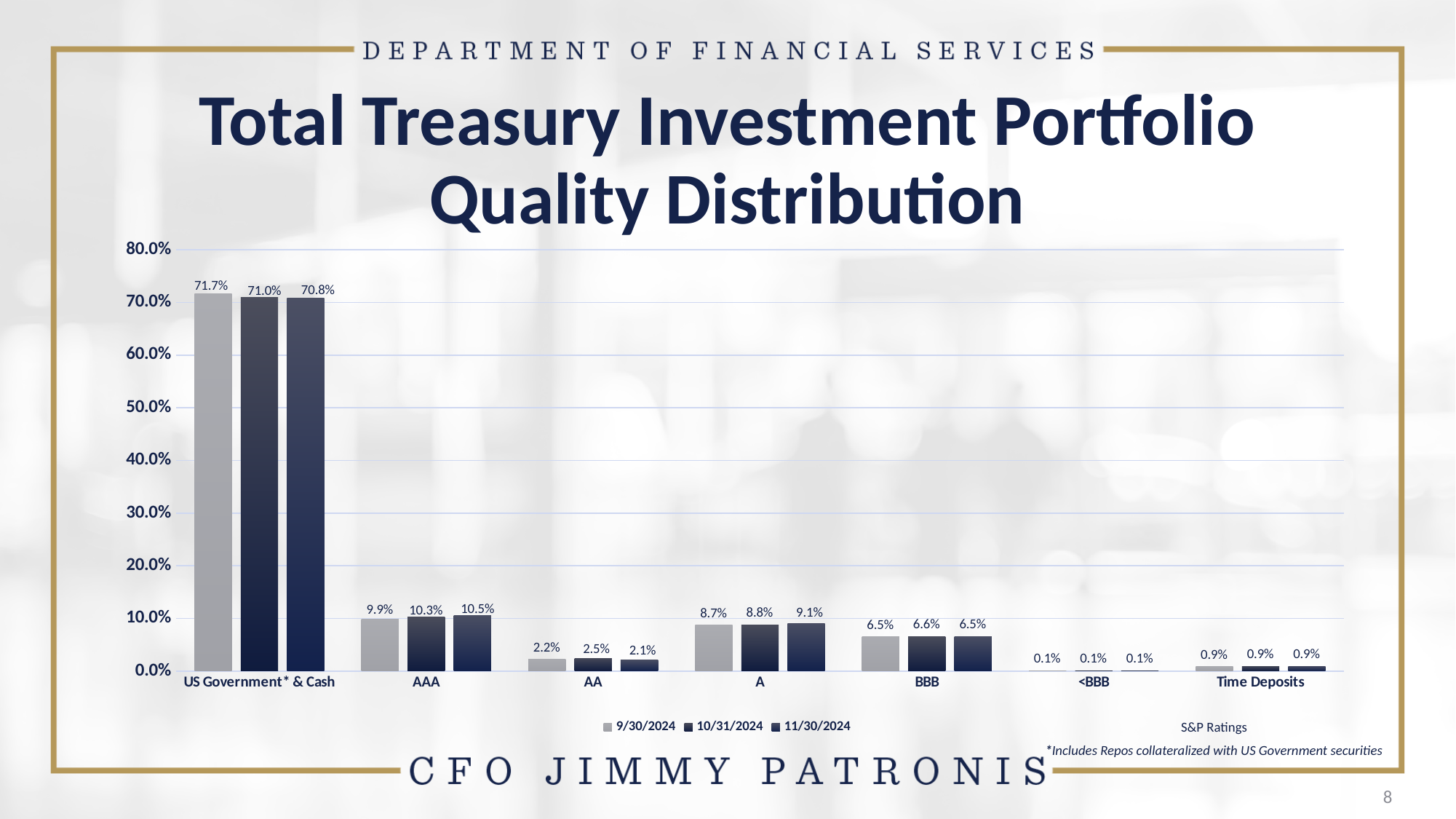
How many categories are shown on the x axis? 7 What kind of chart is shown on the slide? bar chart Which is larger for the A category: the 9/30/2024 value or the 11/30/2024 value? 11/30/2024 What is the value for US Government* & Cash in the 9/30/2024 series? 71.7% What is the value for Time Deposits in the 9/30/2024 series? 0.9% What is the value for AAA in the 11/30/2024 series? 10.5% What is the difference between the 9/30/2024 and 11/30/2024 values for US Government* & Cash? 0.9% Which category has the highest value in the 11/30/2024 series? US Government* & Cash How many series does the legend list? 3 Which category has the lowest value in the 10/31/2024 series? <BBB Is the 10/31/2024 value for US Government* & Cash greater or less than 60.0%? greater What is the value for AA in the 10/31/2024 series? 2.5%